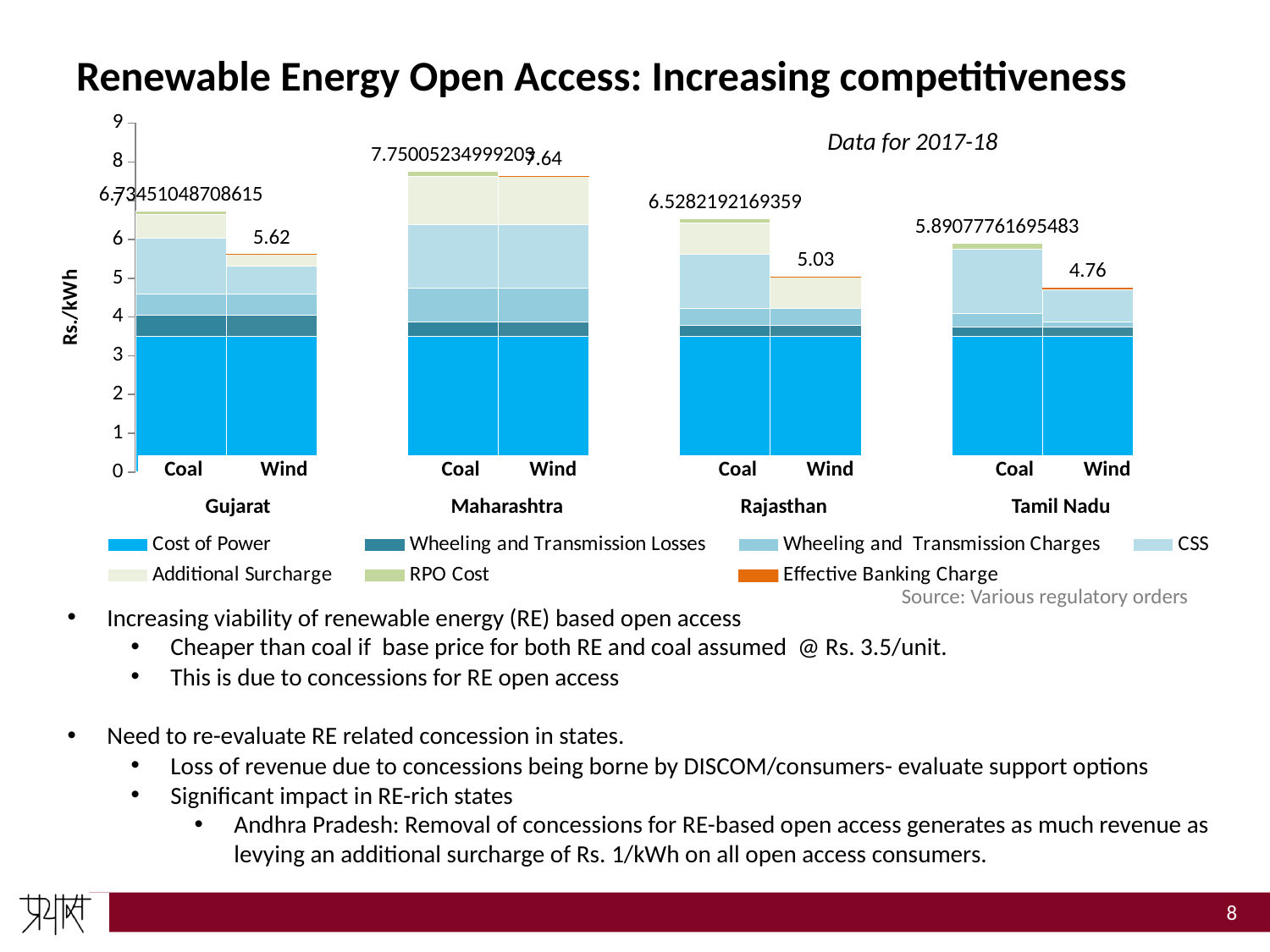
How many series does the legend list? 7 What is the difference between the Wind bar totals for Maharashtra and Gujarat? 2.02 What is the total value labelled for the Coal bar in Maharashtra? 7.75005234999203 What kind of chart is shown on the slide? Stacked bar chart Is the total value for the Wind bar in Maharashtra greater or less than 7? greater What is the total value labelled for the Wind bar in Gujarat? 5.62 What is the total value labelled for the Wind bar in Tamil Nadu? 4.76 In Rajasthan, which bar is taller, Coal or Wind? Coal Which bar has the highest total value on the chart? Maharashtra Coal What is the label on the vertical axis of the chart? Rs./kWh Which bar has the lowest total value on the chart? Tamil Nadu Wind How many bars are plotted on the chart? 8